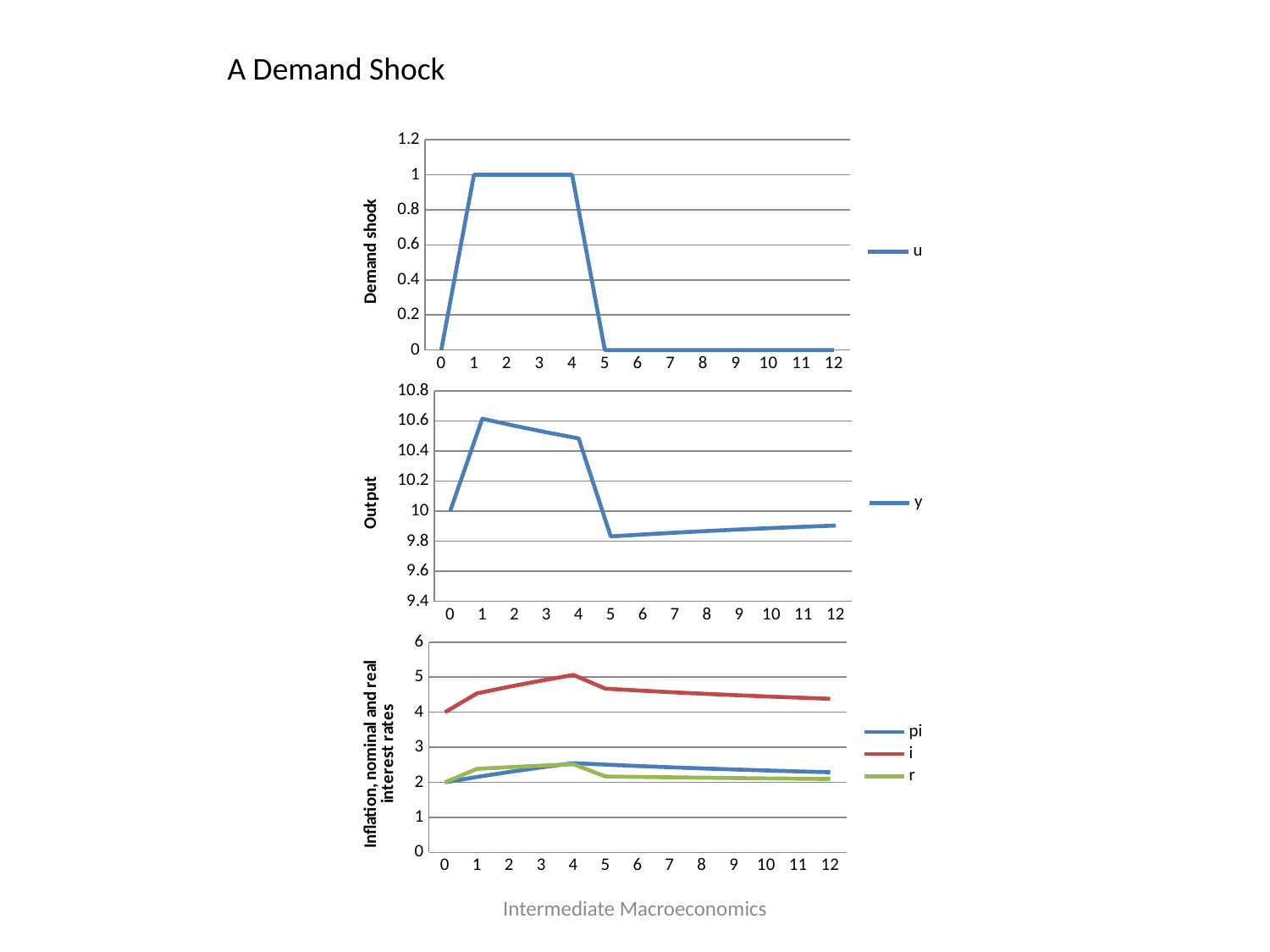
In the middle chart (Output), at which period is y highest? 1 In the middle chart (Output), is the value of y at period 5 greater or less than 10? less In the top chart (Demand shock), what is the value of u at period 8? 0 In the top chart (Demand shock), what is the value of u at period 2? 1 What type of chart is the top chart (Demand shock)? line chart In the bottom chart (Inflation, nominal and real interest rates), what is the value of i at period 0? 4 In the middle chart (Output), what is the value of y at period 0? 10 In the top chart (Demand shock), what is the value of u at period 0? 0 In the middle chart (Output), is the value of y at period 1 greater or less than 10.4? greater In the bottom chart (Inflation, nominal and real interest rates), how many series does the legend list? 3 In the bottom chart (Inflation, nominal and real interest rates), which series is higher at period 8, i or pi? i